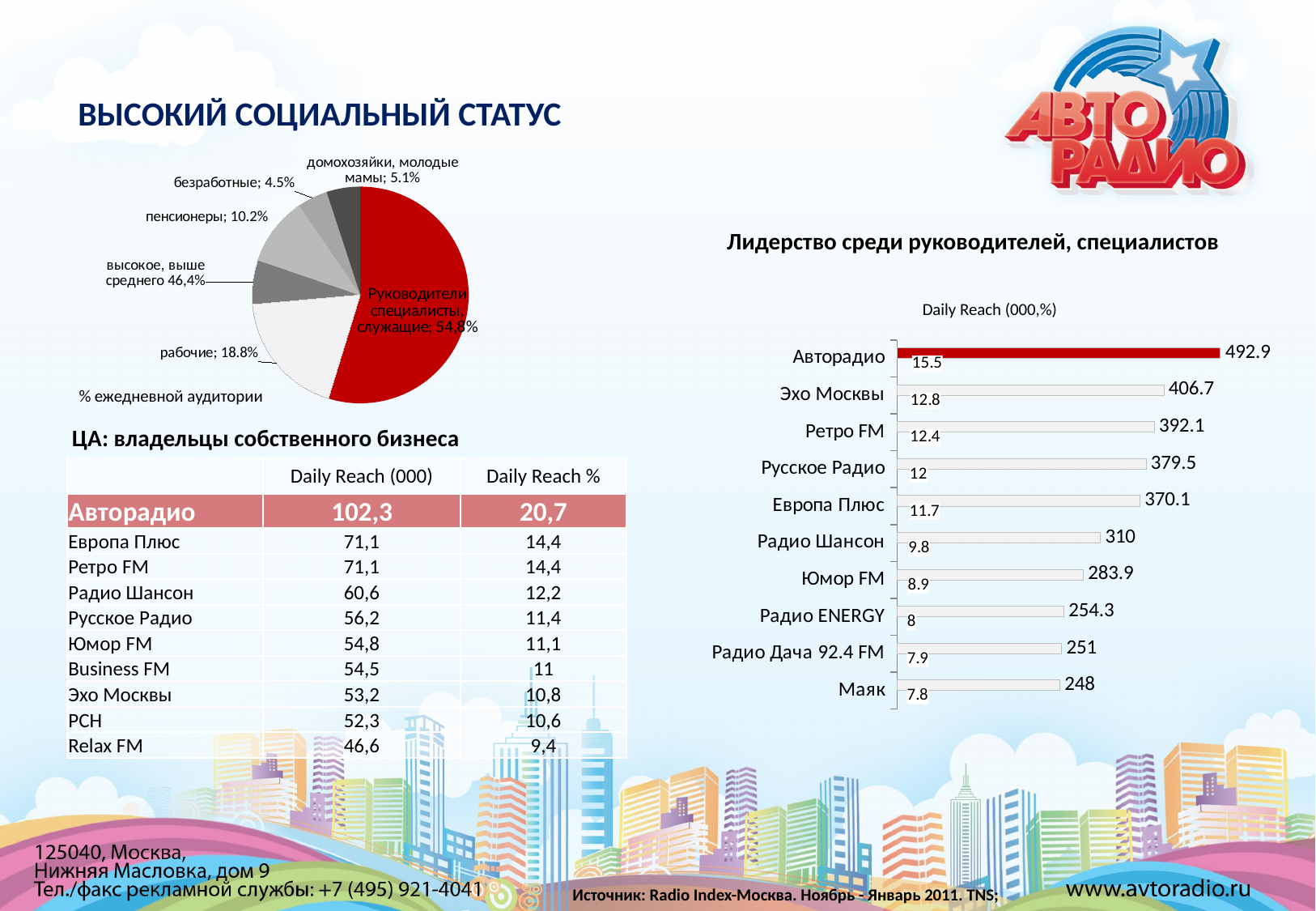
What type of chart is 'Лидерство среди руководителей, специалистов'? Bar chart In the bar chart 'Лидерство среди руководителей, специалистов', which station has the lowest Daily Reach (000) value? Маяк In the pie chart on the left, what share is shown for 'рабочие'? 18.8% In the bar chart 'Лидерство среди руководителей, специалистов', what is the Daily Reach % value shown for Эхо Москвы? 12.8 In the bar chart 'Лидерство среди руководителей, специалистов', what is the difference between the Daily Reach (000) values of Авторадио and Эхо Москвы? 86.2 In the pie chart on the left, what share is shown for 'Руководители, специалисты, служащие'? 54,8% In the bar chart 'Лидерство среди руководителей, специалистов', which station has the highest Daily Reach (000) value? Авторадио In the bar chart 'Лидерство среди руководителей, специалистов', which has a larger Daily Reach (000) value: Радио Шансон or Юмор FM? Радио Шансон In the bar chart 'Лидерство среди руководителей, специалистов', what is the Daily Reach (000) value for Авторадио? 492.9 How many stations are listed in the bar chart 'Лидерство среди руководителей, специалистов'? 10 In the bar chart 'Лидерство среди руководителей, специалистов', what colour is the bar for Авторадио? Red In the pie chart on the left, what share is shown for 'безработные'? 4.5%